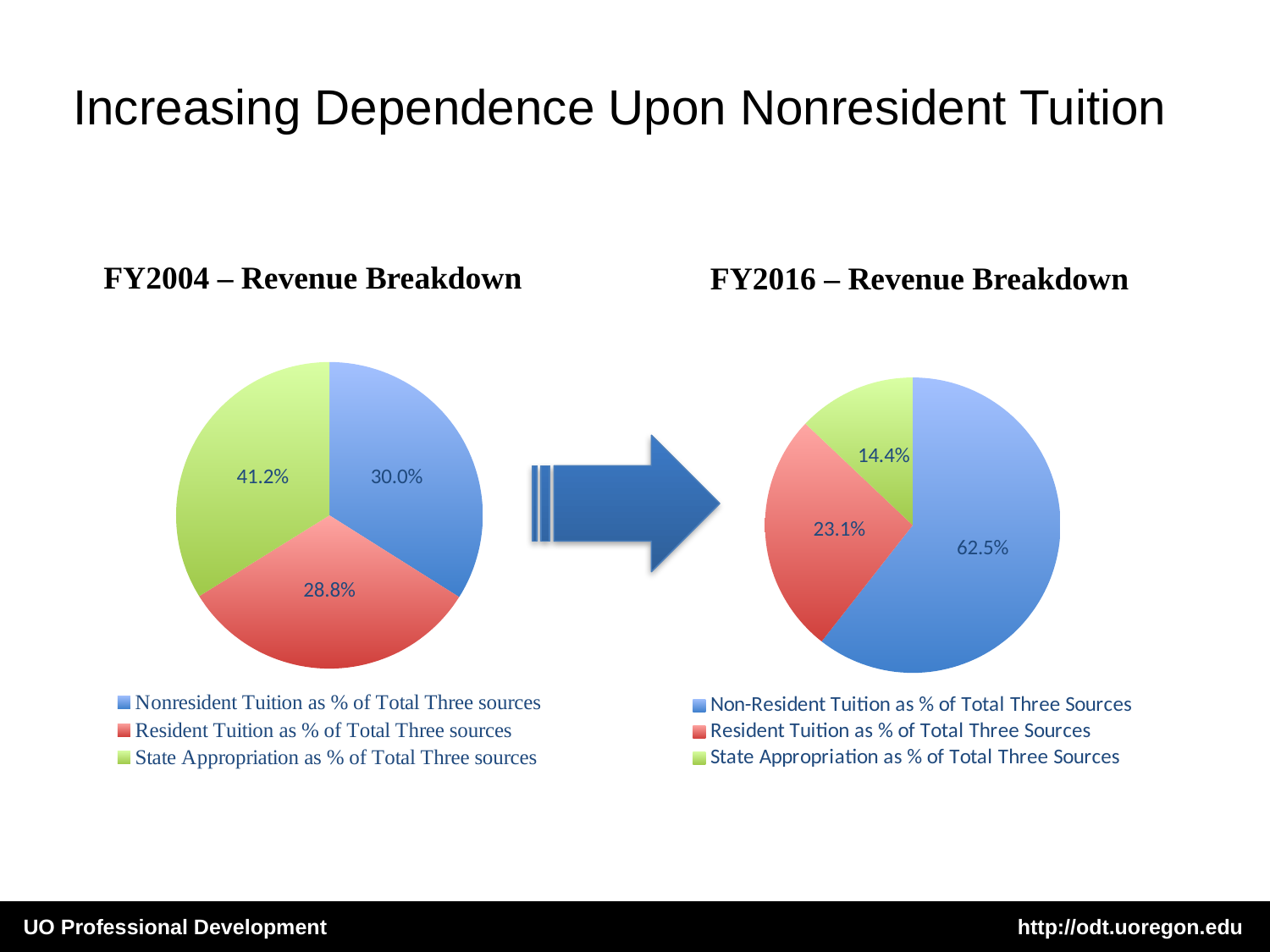
In the FY2016 – Revenue Breakdown chart, which source has the smallest slice? State Appropriation as % of Total Three Sources In the FY2004 – Revenue Breakdown chart, what share is labelled for State Appropriation as % of Total Three sources? 41.2% How many slices does the FY2016 – Revenue Breakdown chart have? 3 In the FY2004 – Revenue Breakdown chart, which is larger: the Nonresident Tuition slice or the Resident Tuition slice? Nonresident Tuition as % of Total Three sources What type of chart is the FY2004 – Revenue Breakdown chart? Pie chart In the FY2016 – Revenue Breakdown chart, what share is labelled for Resident Tuition as % of Total Three Sources? 23.1% In the FY2004 – Revenue Breakdown chart, what share is labelled for Nonresident Tuition as % of Total Three sources? 30.0% In the FY2016 – Revenue Breakdown chart, what colour is the Non-Resident Tuition slice? Blue In the FY2016 – Revenue Breakdown chart, what is the difference between the Non-Resident Tuition share and the Resident Tuition share? 39.4% In the FY2004 – Revenue Breakdown chart, which source has the largest slice? State Appropriation as % of Total Three sources In the FY2016 – Revenue Breakdown chart, what share is labelled for Non-Resident Tuition as % of Total Three Sources? 62.5% In the FY2004 – Revenue Breakdown chart, what is the difference between the State Appropriation share and the Resident Tuition share? 12.4%